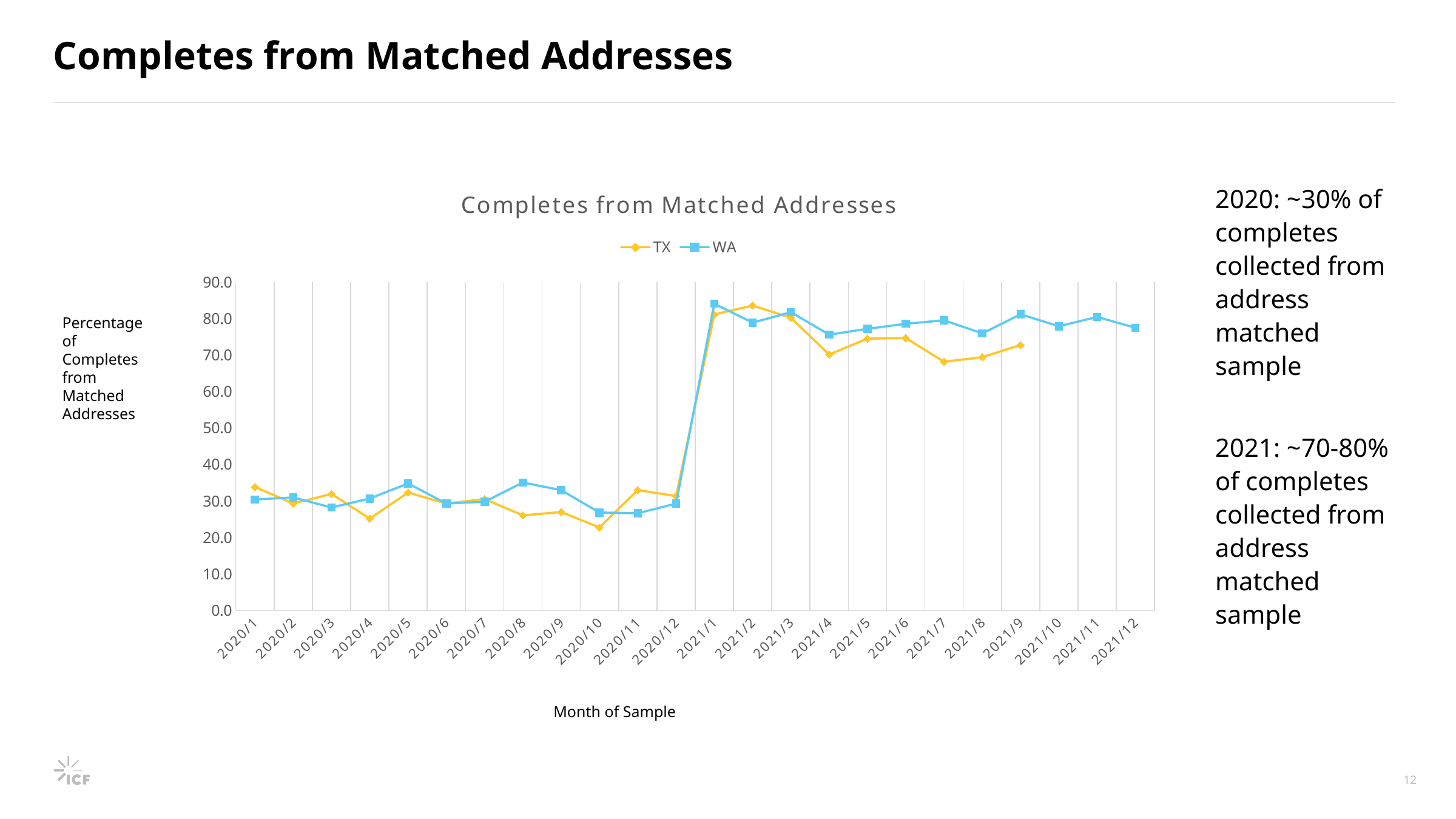
Is the value for WA in 2021/1 greater or less than 80.0? greater What is the title of the x axis of the chart? Month of Sample What kind of chart is shown on the slide? line chart How many months are shown on the x axis of the chart? 24 Is the value for TX in 2021/2 greater or less than 80.0? greater How many series does the chart legend list? 2 Is the value for TX in 2020/10 greater or less than 30.0? less In 2020/10, which series has the larger value, TX or WA? WA In 2021/7, which series has the larger value, TX or WA? WA Do the values for both series rise or fall between 2020/12 and 2021/1? rise